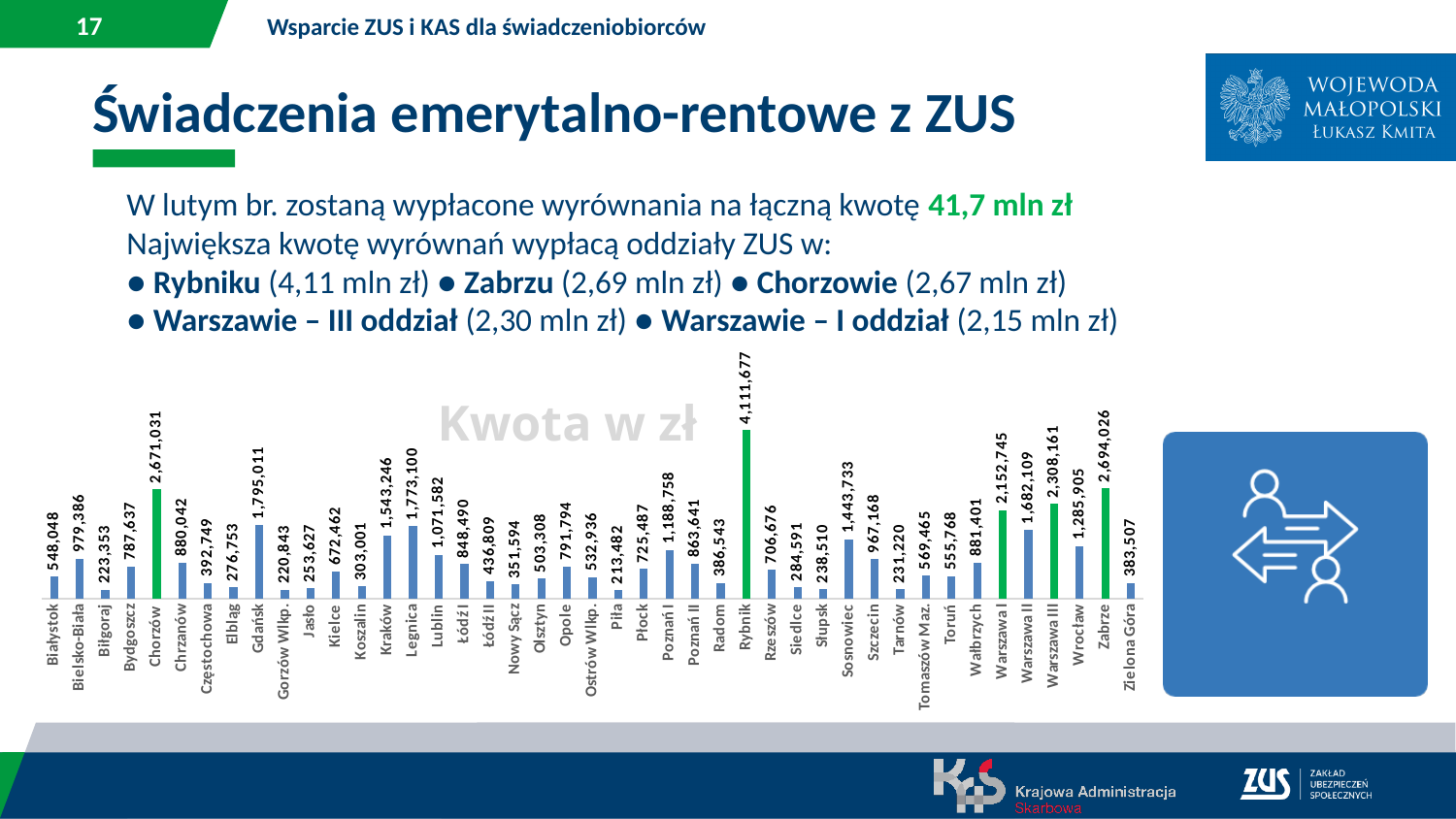
What is the difference between the values for Rybnik and Zabrze in the 'Kwota w zł' chart? 1,417,651 Which category has the lowest value in the 'Kwota w zł' chart? Piła What kind of chart is the 'Kwota w zł' chart? Bar chart Which category has the highest value in the 'Kwota w zł' chart? Rybnik Which has a larger value in the 'Kwota w zł' chart, Gdańsk or Legnica? Gdańsk What is the difference between the values for Zabrze and Chorzów in the 'Kwota w zł' chart? 22,995 What is the value for Zielona Góra in the 'Kwota w zł' chart? 383,507 How many categories are shown in the 'Kwota w zł' chart? 43 What is the value for Kraków in the 'Kwota w zł' chart? 1,543,246 What is the value for Rybnik in the 'Kwota w zł' chart? 4,111,677 Which has a larger value in the 'Kwota w zł' chart, Warszawa III or Warszawa I? Warszawa III How many bars in the 'Kwota w zł' chart are coloured green? 5